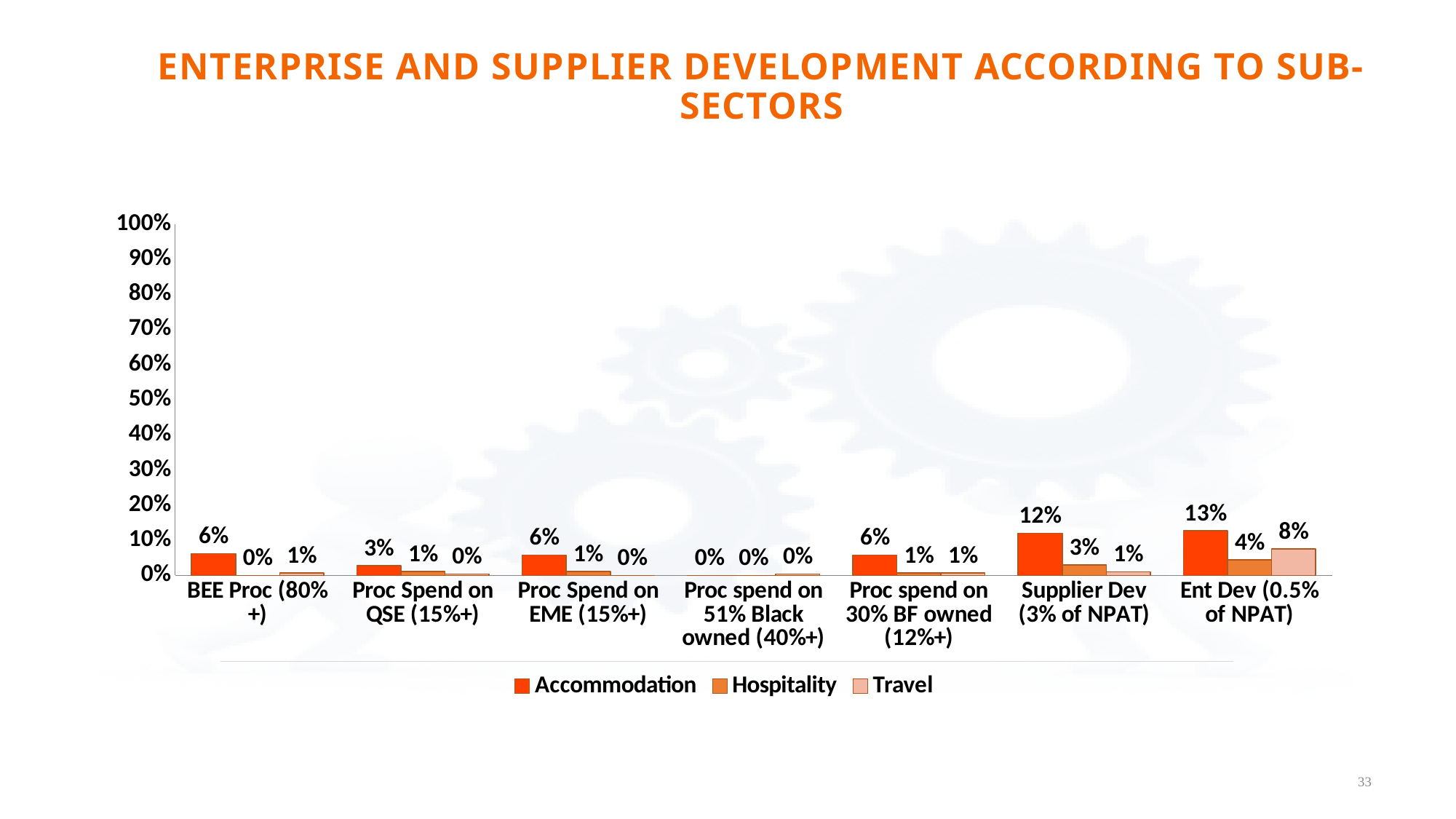
What is the Hospitality value for Supplier Dev (3% of NPAT)? 3% How many categories are shown on the x axis? 7 How many series does the legend list? 3 What kind of chart is shown on the slide? Bar chart Which is larger for Ent Dev (0.5% of NPAT): the Hospitality value or the Travel value? Travel What is the Travel value for Ent Dev (0.5% of NPAT)? 8% What is the Accommodation value for Ent Dev (0.5% of NPAT)? 13% What is the Accommodation value for BEE Proc (80% +)? 6% Which category has the highest Travel value? Ent Dev (0.5% of NPAT) What is the difference between the Accommodation and Travel values for Supplier Dev (3% of NPAT)? 11% What are the three series listed in the legend? Accommodation, Hospitality, Travel Which category has the highest Accommodation value? Ent Dev (0.5% of NPAT)